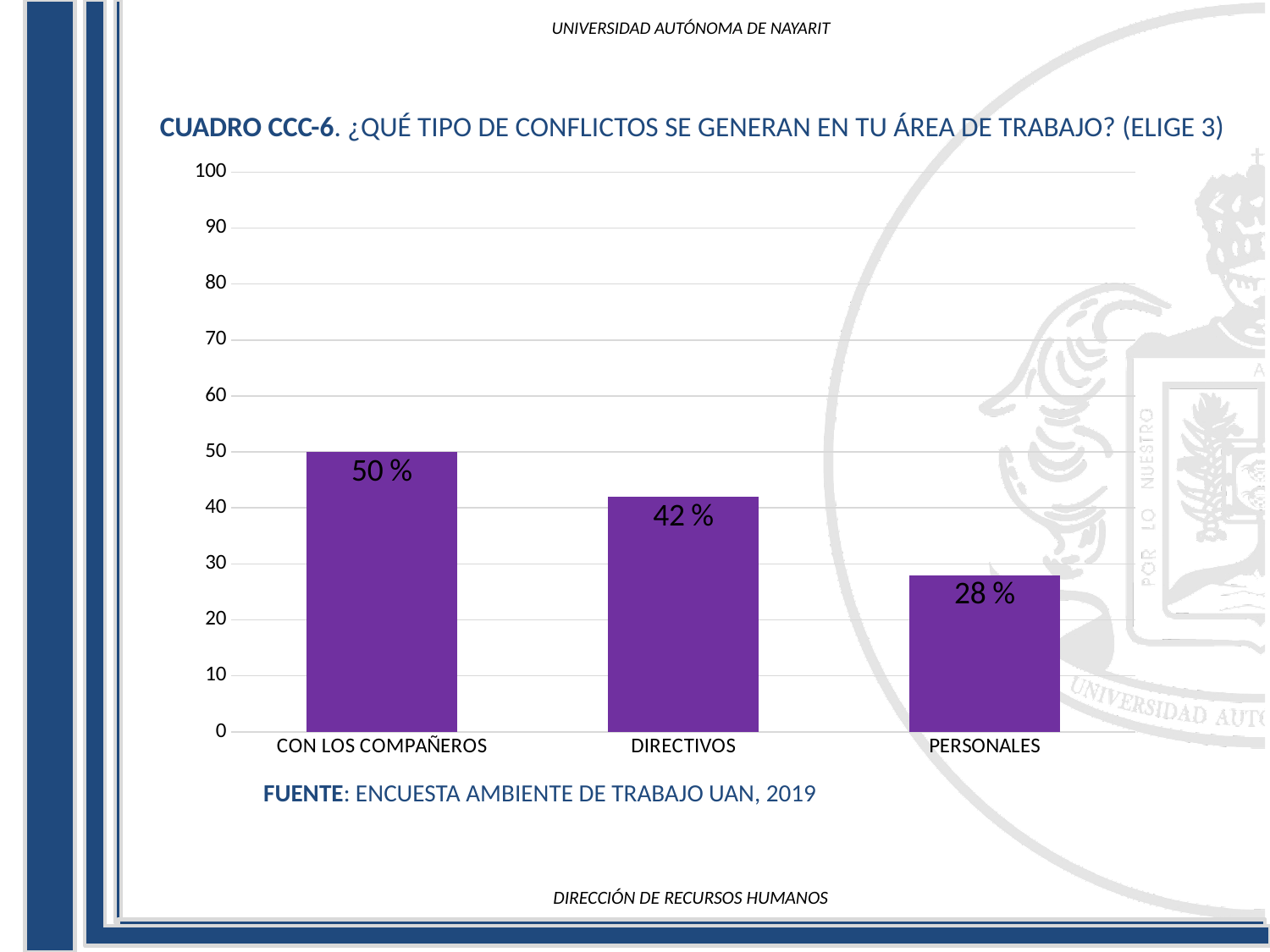
What is the difference between the values for CON LOS COMPAÑEROS and PERSONALES? 22 % What is the value for CON LOS COMPAÑEROS? 50 % What kind of chart is shown on the slide? bar chart How many categories are shown in the chart? 3 What is the difference between the values for DIRECTIVOS and PERSONALES? 14 % What is the value for DIRECTIVOS? 42 % What source is cited below the chart? ENCUESTA AMBIENTE DE TRABAJO UAN, 2019 What is the value for PERSONALES? 28 % Which is larger, the value for DIRECTIVOS or the value for PERSONALES? DIRECTIVOS Which category has the highest value? CON LOS COMPAÑEROS Which category has the lowest value? PERSONALES Is the value for DIRECTIVOS greater or less than 40? greater